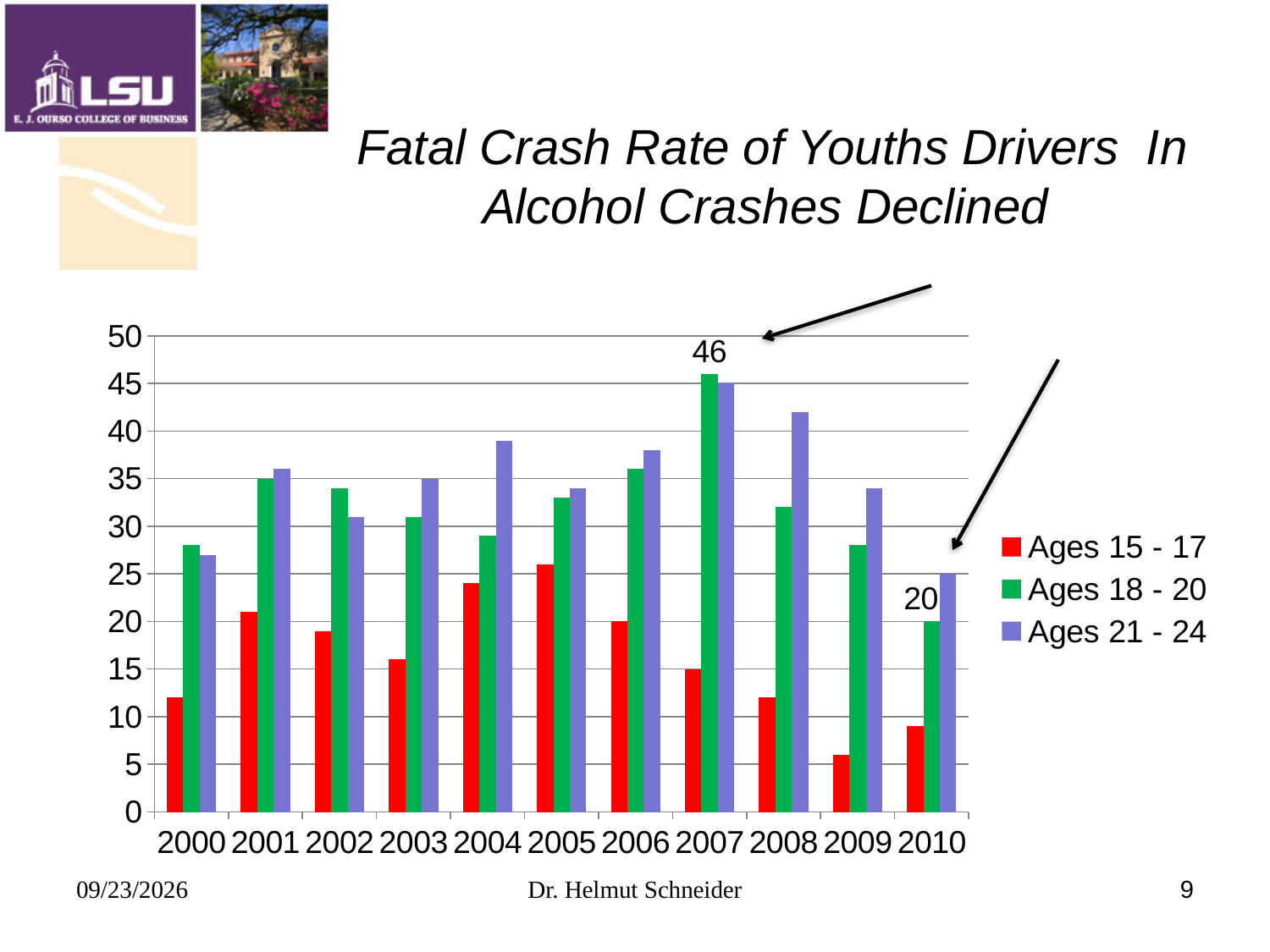
In which year is the value for Ages 18 - 20 highest? 2007 How many years are shown on the x axis? 11 What kind of chart is shown on the slide? bar chart What is the value for Ages 18 - 20 in 2010? 20 Which year has the larger value for Ages 18 - 20, 2007 or 2010? 2007 What is the value for Ages 18 - 20 in 2007? 46 What is the difference between the Ages 18 - 20 values in 2007 and 2010? 26 Is the value for Ages 15 - 17 in 2009 greater or less than 10? less How many series does the legend list? 3 Is the value for Ages 21 - 24 in 2008 greater or less than 40? greater In which year is the value for Ages 15 - 17 lowest? 2009